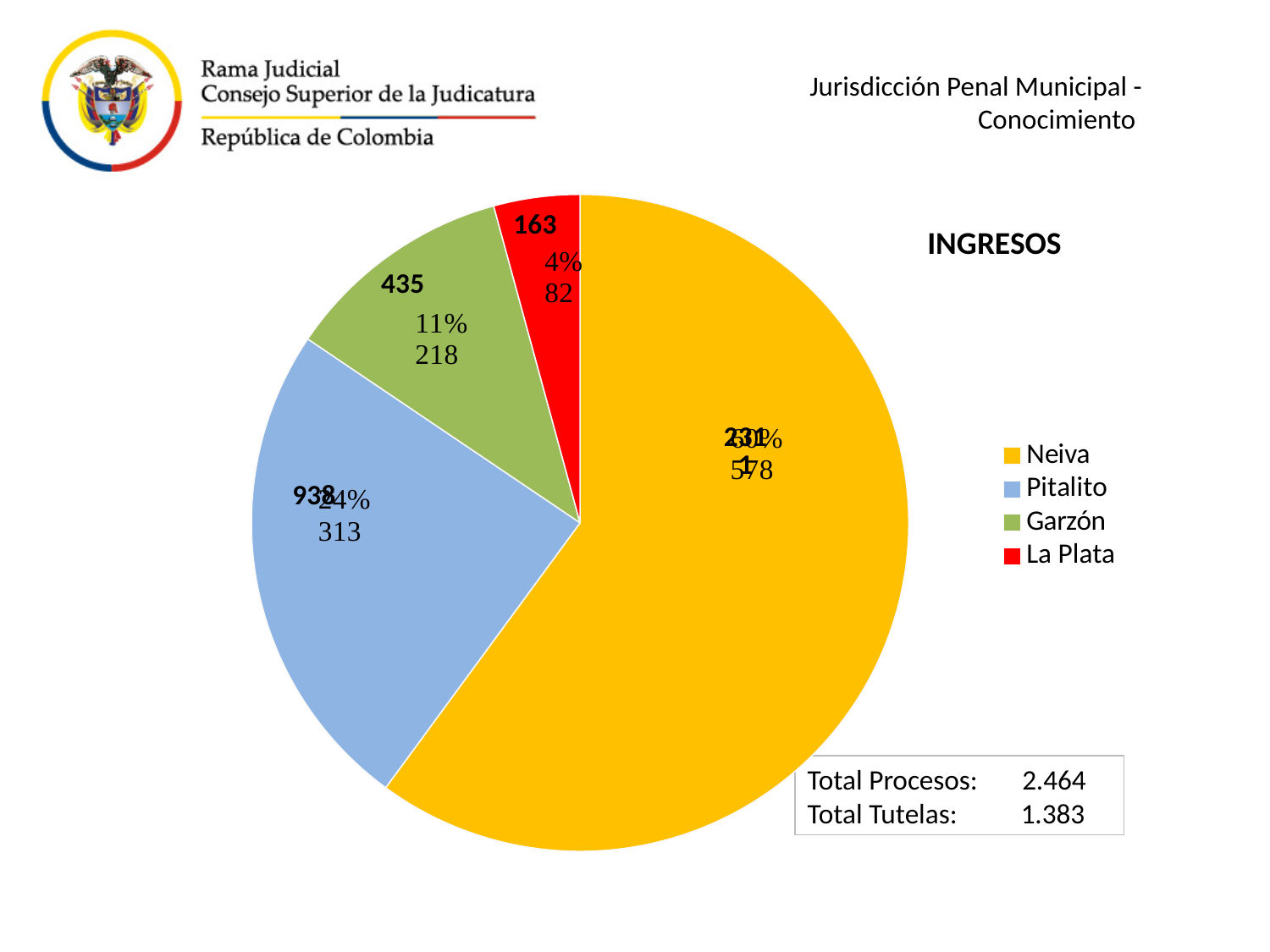
Which category has the smallest slice of the pie chart? La Plata What bold value is printed on the La Plata slice? 163 What is the title of the pie chart? INGRESOS What bold value is printed on the Garzón slice? 435 How many entries does the legend of the pie chart list? 4 What percentage share is shown on the La Plata slice? 4% Which category has the largest slice of the pie chart? Neiva How many slices does the pie chart have? 4 Which slice is larger, Garzón or La Plata? Garzón What percentage share is shown on the Garzón slice? 11% What kind of chart is shown on the slide? pie chart Which slice is larger, Pitalito or Garzón? Pitalito